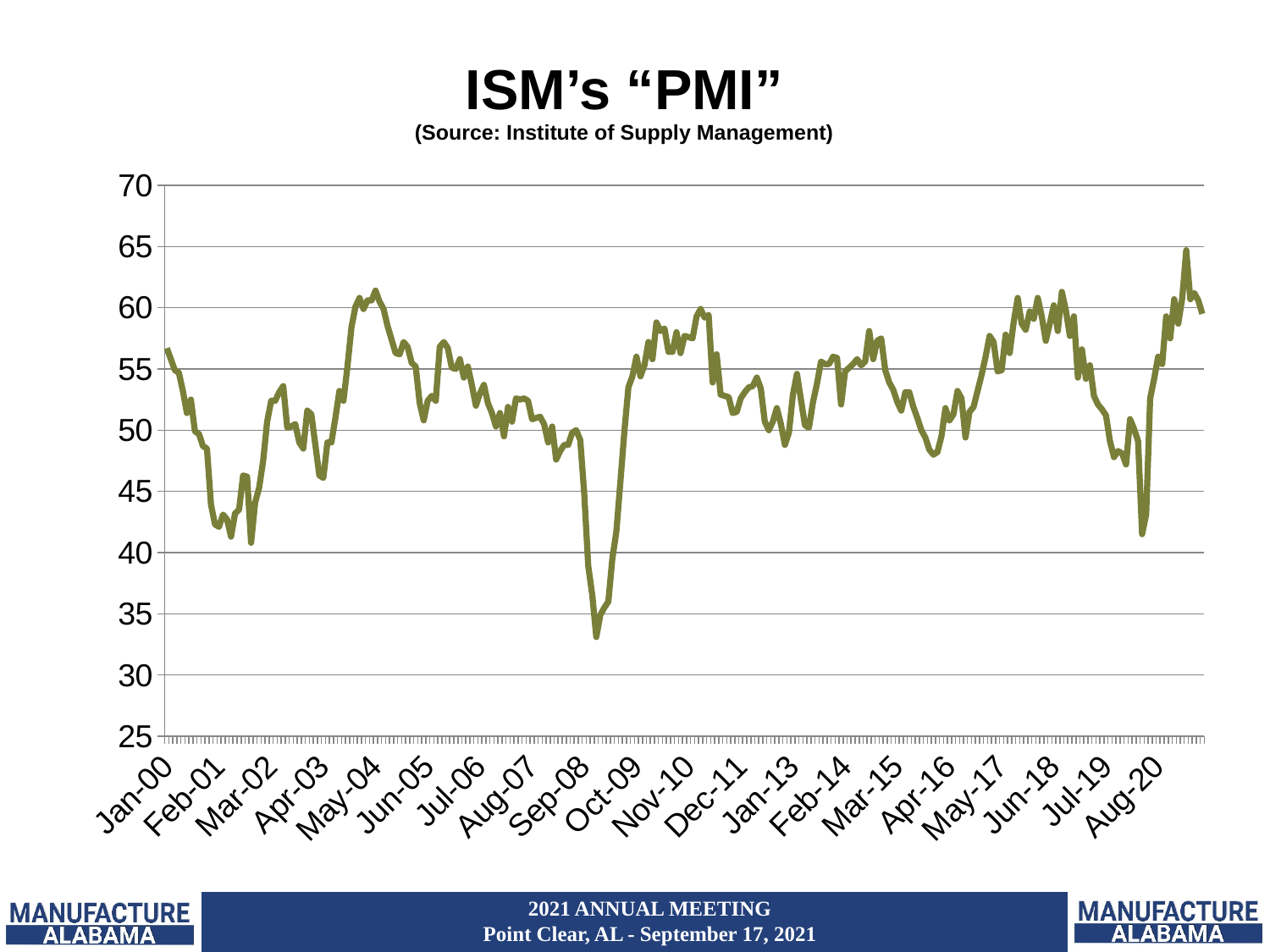
What kind of chart is shown on the slide? line chart Between Jan-00 and Feb-01, does the line rise or fall? fall What is the title of the chart? ISM's "PMI" Is the highest value on the line greater or less than 60? greater Is the value for May-04 greater or less than 55? greater How many lines are plotted on the chart? 1 Is the value for Feb-01 greater or less than 45? less Which is larger, the value for Jan-00 or the value for Feb-01? Jan-00 What is the highest value shown on the y-axis? 70 How many date labels are shown along the x-axis? 20